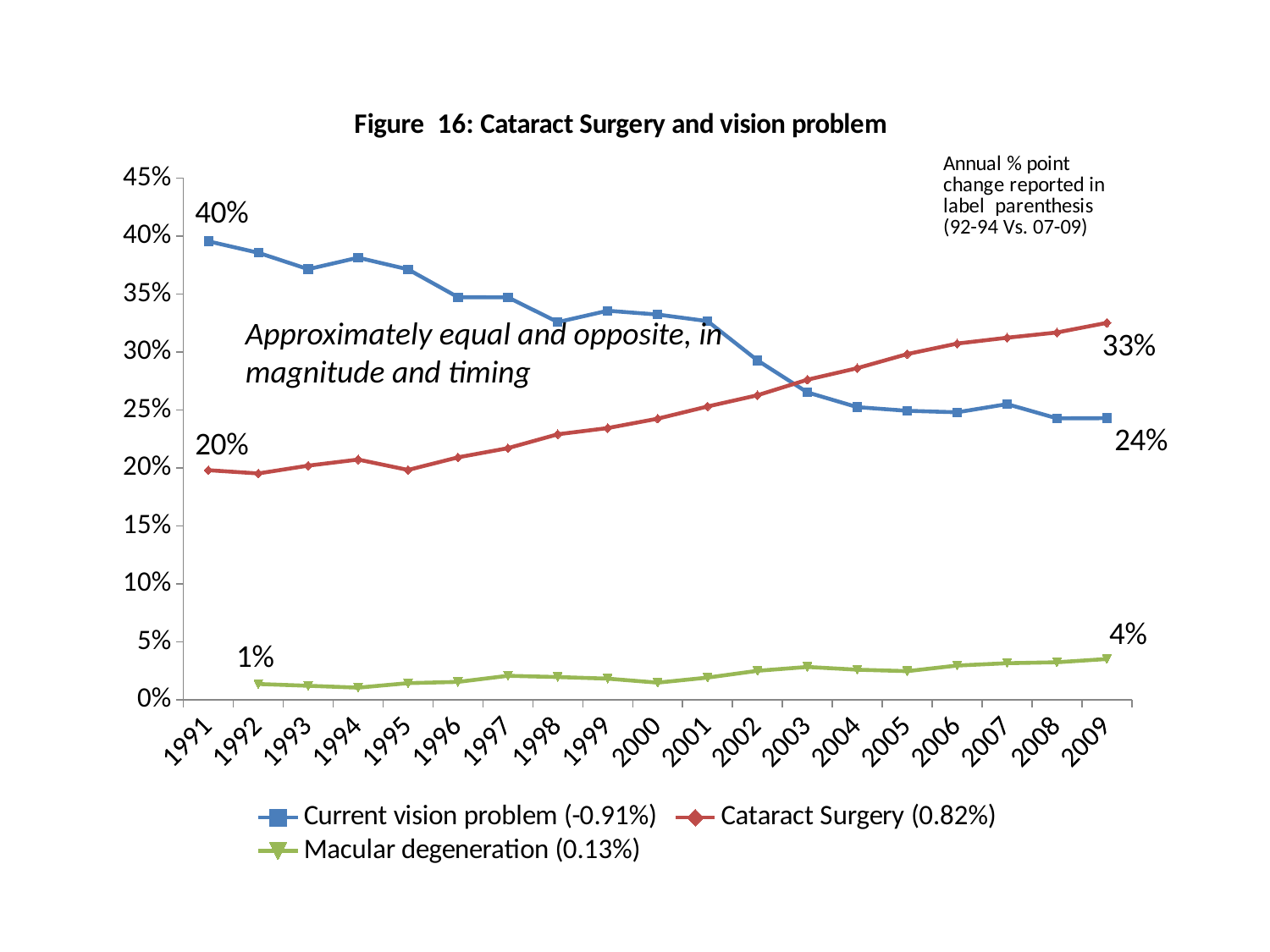
How many years are shown on the x axis? 19 What is the value for Macular degeneration in 2009? 4% In 2009, which is larger: Cataract Surgery or Current vision problem? Cataract Surgery What is the value for Cataract Surgery in 1991? 20% What is the value for Cataract Surgery in 2009? 33% Does the Cataract Surgery line rise or fall from 1991 to 2009? Rises By how many percentage points did Current vision problem fall from 1991 (40%) to 2009 (24%)? 16 percentage points Is the value for Current vision problem in 2005 greater or less than 30%? less What is the value for Current vision problem in 1991? 40% What kind of chart is shown on the slide? Line chart How many series does the legend list? 3 What annual % point change is reported in the legend label for Cataract Surgery? 0.82%